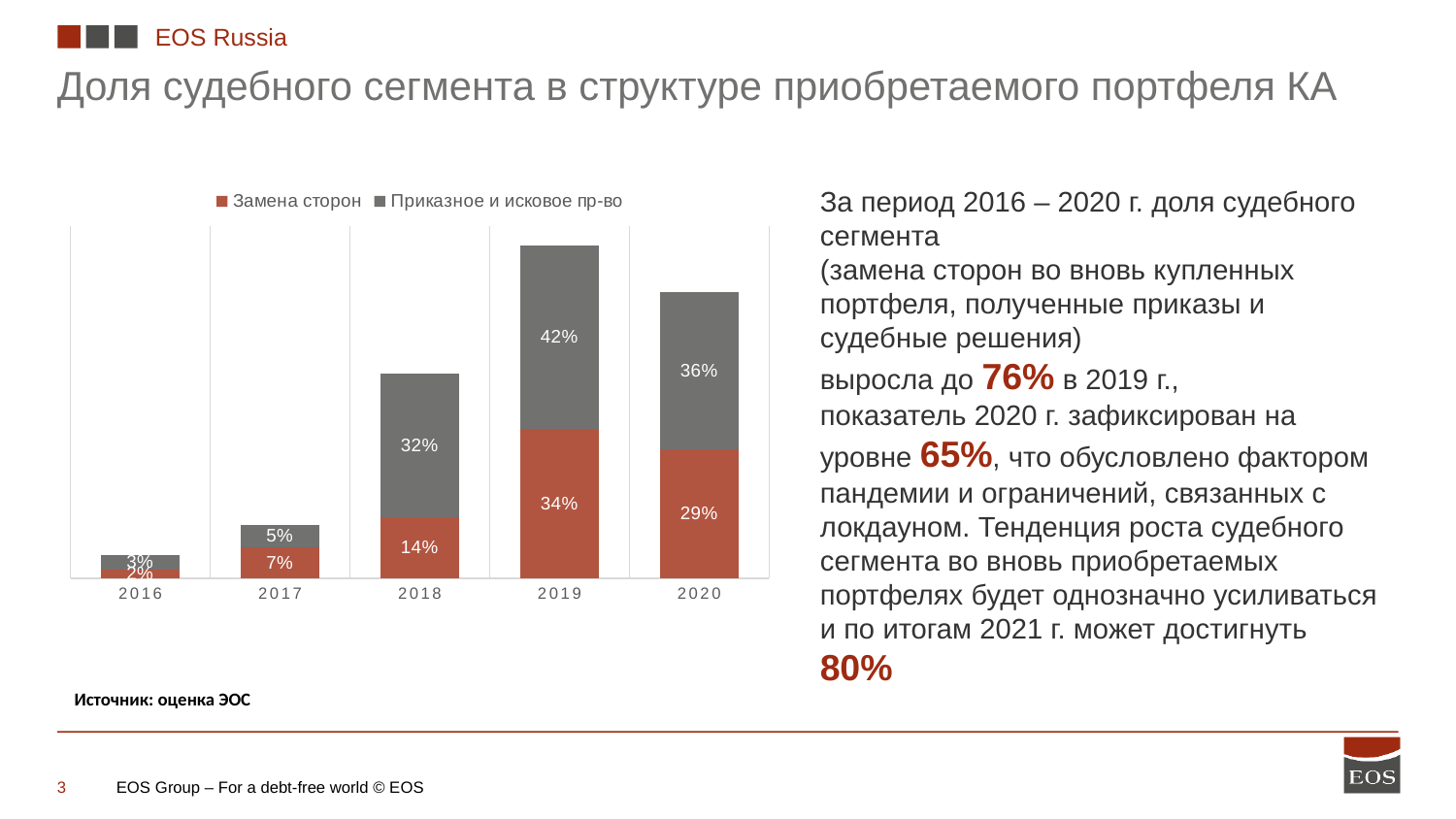
What is the difference between the "Приказное и исковое пр-во" values for 2019 and 2020? 6% Which is larger in 2018: "Замена сторон" or "Приказное и исковое пр-во"? Приказное и исковое пр-во What is the value for "Приказное и исковое пр-во" in 2018? 32% In which year is the total stacked bar the tallest? 2019 What is the value for "Замена сторон" in 2020? 29% What is the value for "Приказное и исковое пр-во" in 2017? 5% In which year is the value for "Приказное и исковое пр-во" highest? 2019 How many series does the chart legend list? 2 What kind of chart is shown on the slide? stacked bar chart How many years are shown on the x axis of the chart? 5 What is the total of the stacked bar for 2019? 76% What is the value for "Замена сторон" in 2019? 34%